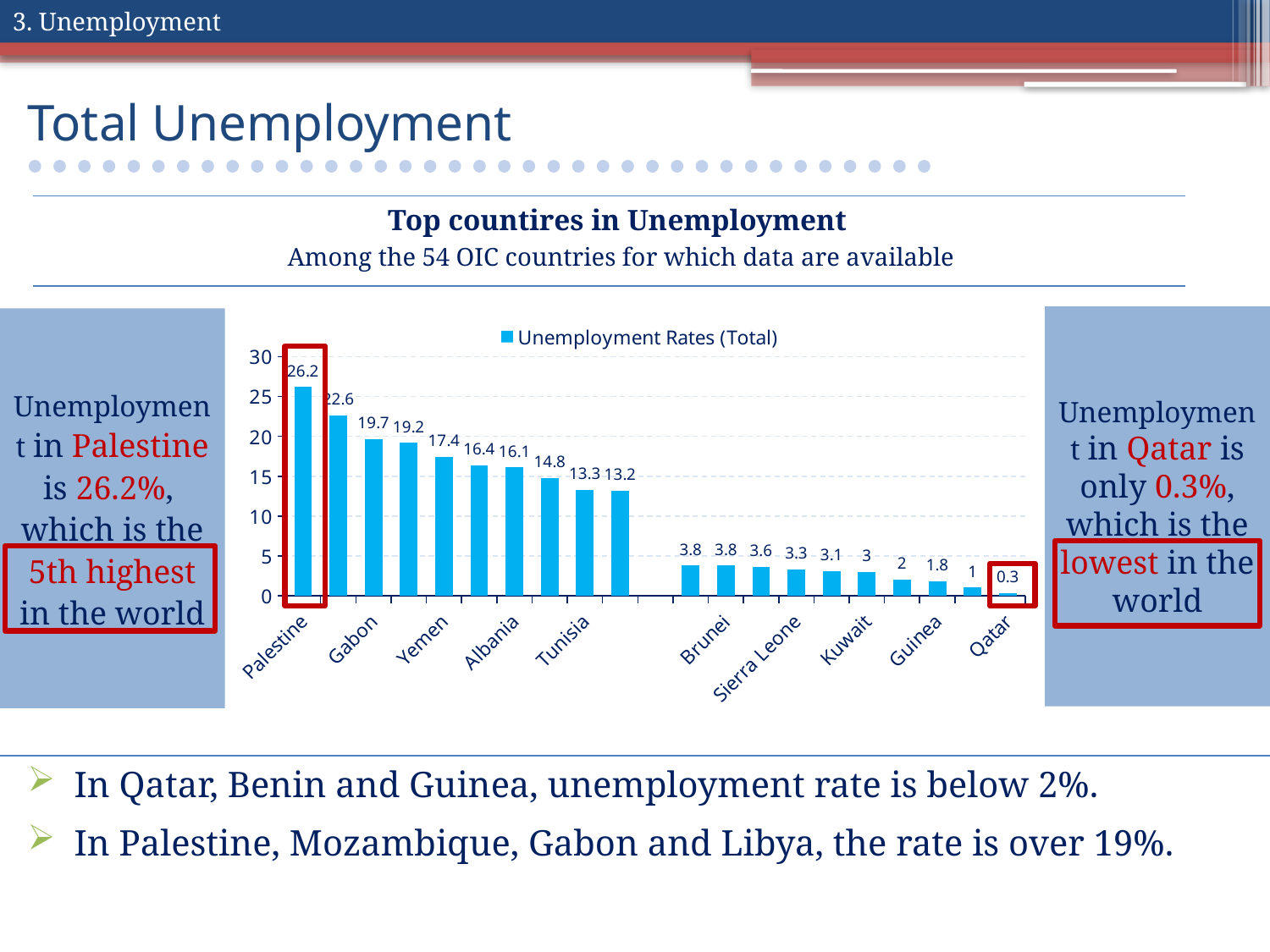
What is the difference between the unemployment rates of Palestine and Qatar? 25.9 Which country has the lowest unemployment rate in the chart? Qatar How many series does the legend list? 1 What is the unemployment rate for Qatar? 0.3 Do the values rise or fall from left to right along the x axis? fall Which country has the highest unemployment rate in the chart? Palestine What type of chart is shown on the slide? bar chart What is the unemployment rate for Brunei? 3.8 Which has a higher unemployment rate, Palestine or Gabon? Palestine How many bars are plotted in the chart? 20 What is the unemployment rate for Palestine? 26.2 Is the value for Yemen greater or less than 15? greater